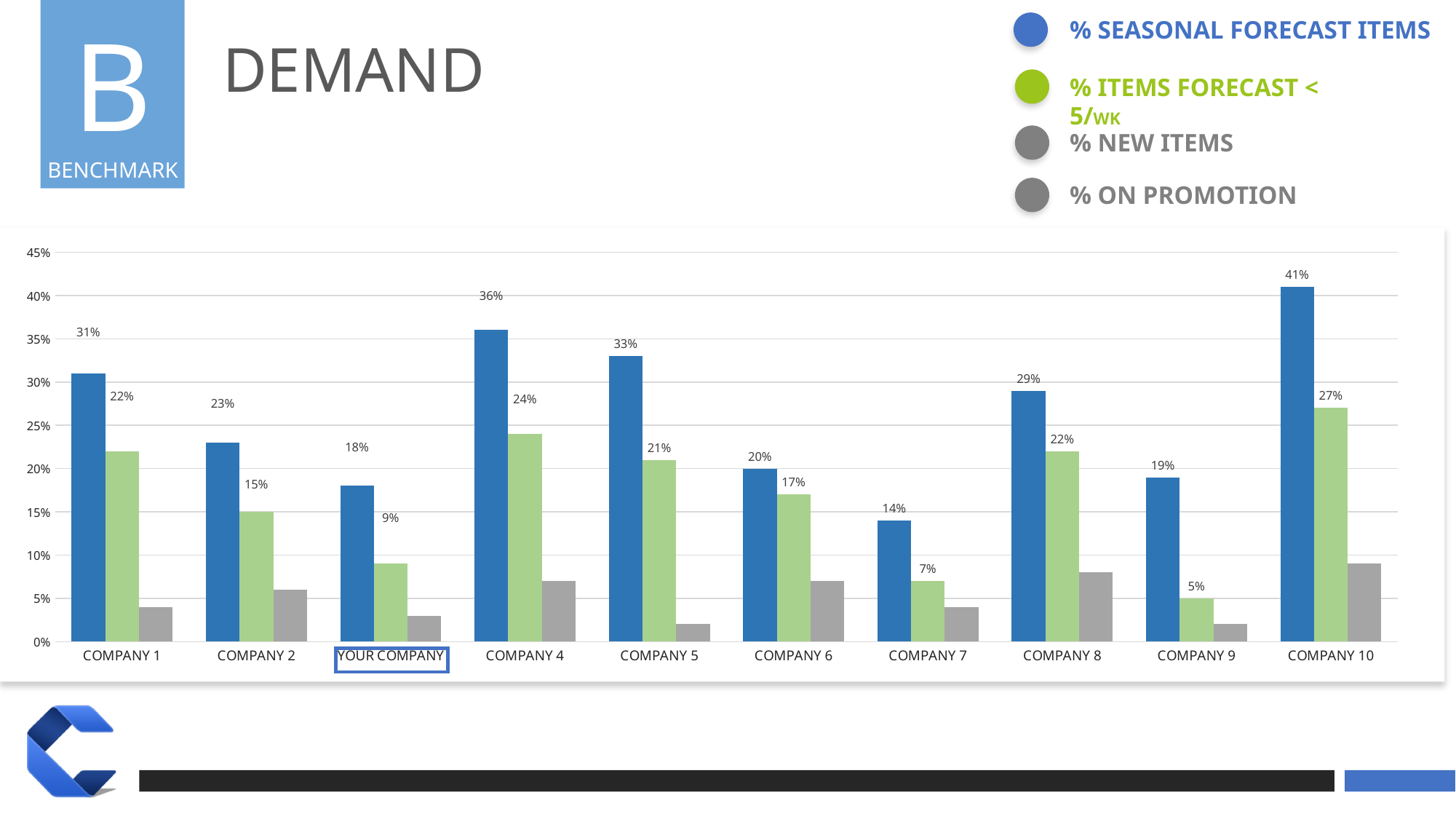
What is the % SEASONAL FORECAST ITEMS value for COMPANY 7? 14% Which company has the lowest % ITEMS FORECAST < 5/WK value? COMPANY 9 What is the % ITEMS FORECAST < 5/WK value for YOUR COMPANY? 9% Is the value of the grey bar for COMPANY 5 greater or less than 5%? less What is the difference between the % SEASONAL FORECAST ITEMS values for COMPANY 10 and YOUR COMPANY? 23% Is the value of the grey bar for COMPANY 8 greater or less than 5%? greater How many companies are shown on the x axis of the chart? 10 What kind of chart is shown on the slide? Bar chart What is the % SEASONAL FORECAST ITEMS value for COMPANY 4? 36% Which has a larger % SEASONAL FORECAST ITEMS value, COMPANY 5 or COMPANY 8? COMPANY 5 Which company has the highest % SEASONAL FORECAST ITEMS value? COMPANY 10 How many entries does the legend list? 4